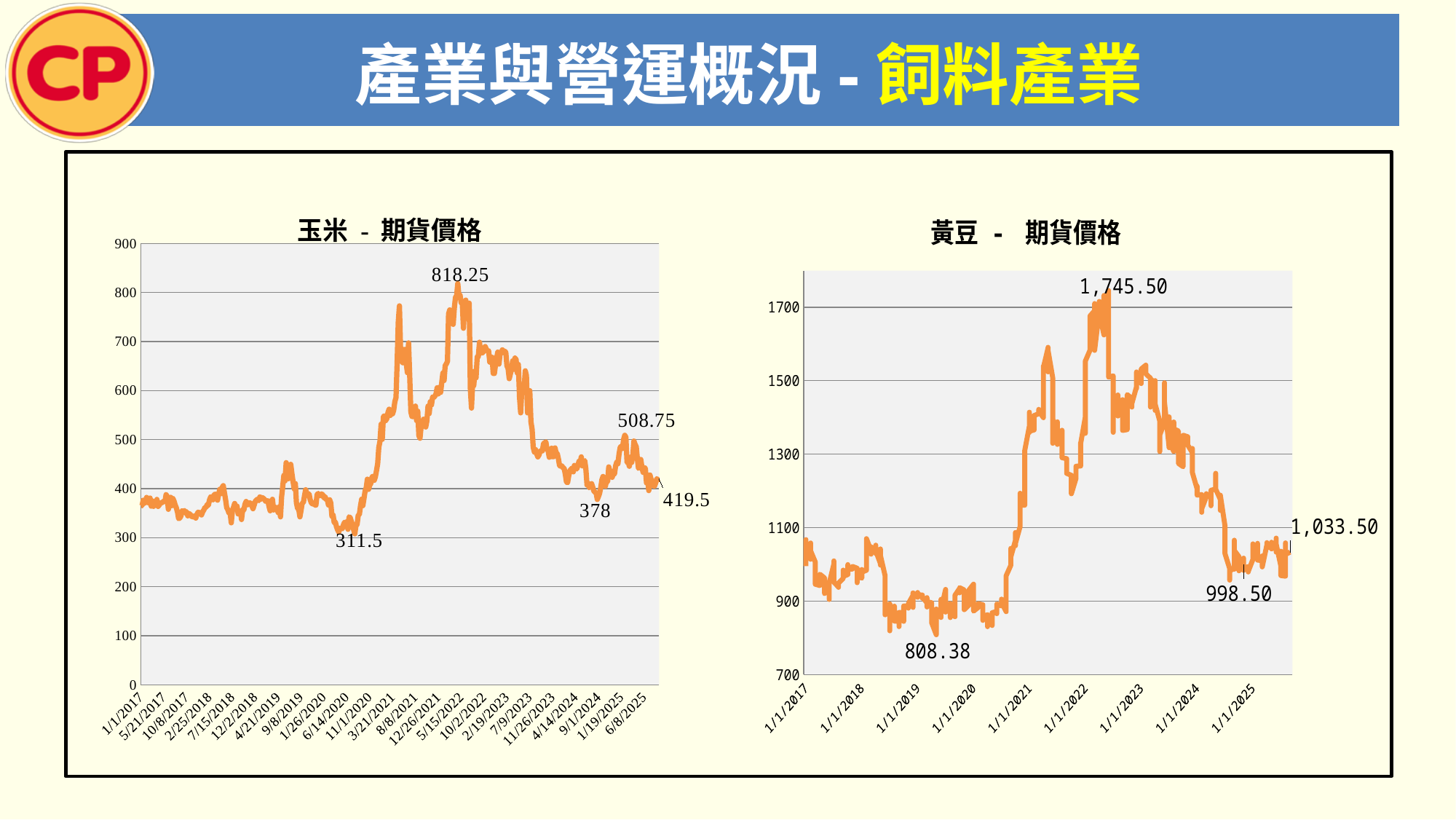
On the 黃豆 - 期貨價格 chart, what is the lowest labelled value? 808.38 On the 黃豆 - 期貨價格 chart, what is the last labelled value at the right end of the line? 1,033.50 On the 玉米 - 期貨價格 chart, which labelled value is larger, 508.75 or 378? 508.75 On the 黃豆 - 期貨價格 chart, what is the highest labelled value? 1,745.50 On the 黃豆 - 期貨價格 chart, is the value at 1/1/2017 greater or less than 1300? less On the 玉米 - 期貨價格 chart, what is the difference between the labelled peak 818.25 and the labelled low 311.5? 506.75 What kind of chart is the 玉米 - 期貨價格 chart? line chart On the 玉米 - 期貨價格 chart, what is the highest labelled value? 818.25 On the 玉米 - 期貨價格 chart, what is the difference between the labelled values 508.75 and 378? 130.75 On the 黃豆 - 期貨價格 chart, what is the difference between the labelled peak 1,745.50 and the labelled low 808.38? 937.12 On the 玉米 - 期貨價格 chart, what is the last labelled value at the right end of the line? 419.5 On the 玉米 - 期貨價格 chart, what is the lowest labelled value? 311.5